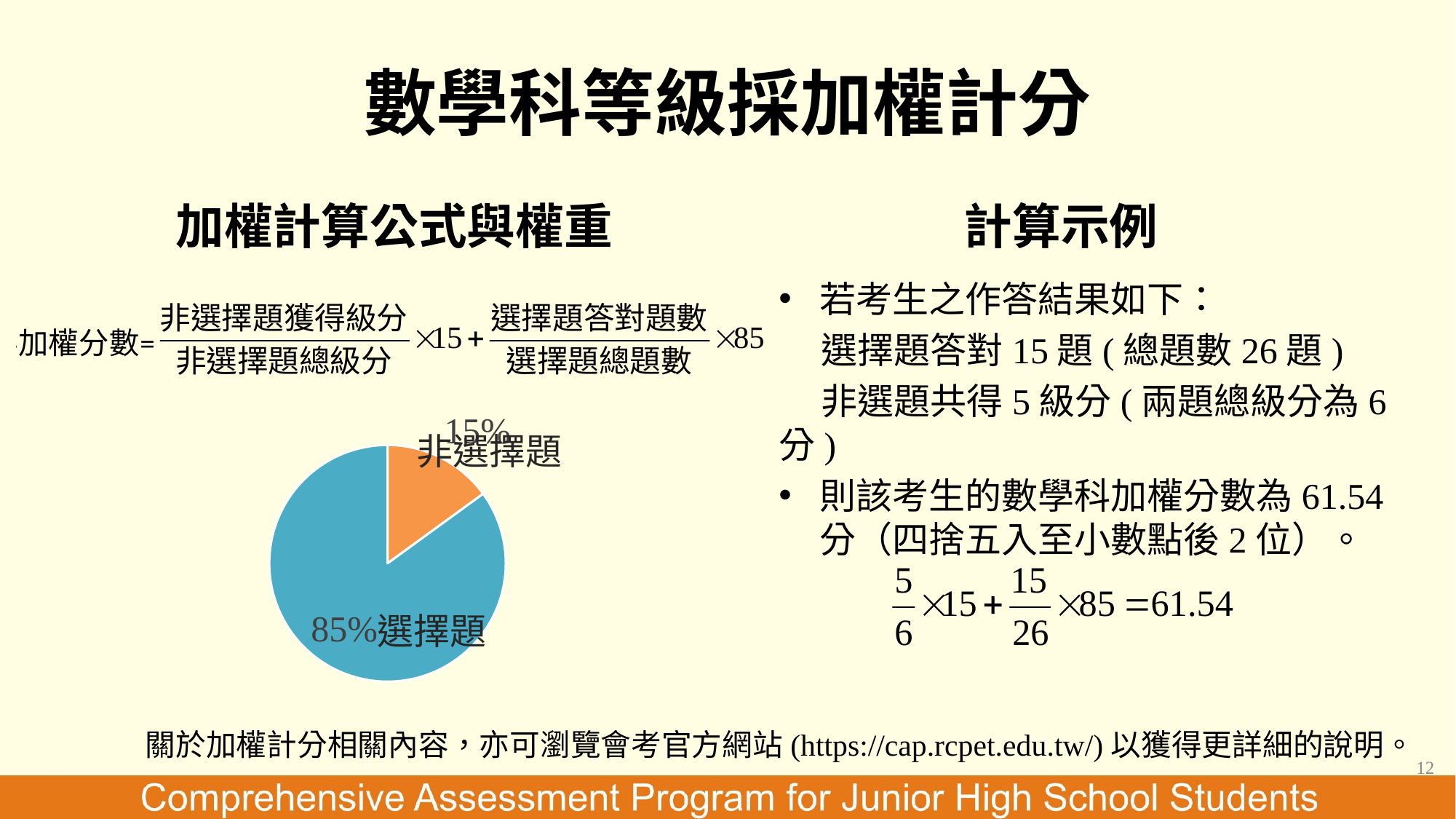
Which is larger in the pie chart, 選擇題 or 非選擇題? 選擇題 Which slice of the pie chart is the largest? 選擇題 What colour is the 非選擇題 slice in the pie chart? orange Is the share for 非選擇題 greater or less than 50%? less How many slices does the pie chart have? 2 What colour is the 選擇題 slice in the pie chart? blue What share of the pie does 非選擇題 take? 15% Which slice of the pie chart is the smallest? 非選擇題 What is the difference in percentage points between the 選擇題 slice and the 非選擇題 slice? 70 What share of the pie does 選擇題 take? 85% What kind of chart is shown on the slide? pie chart